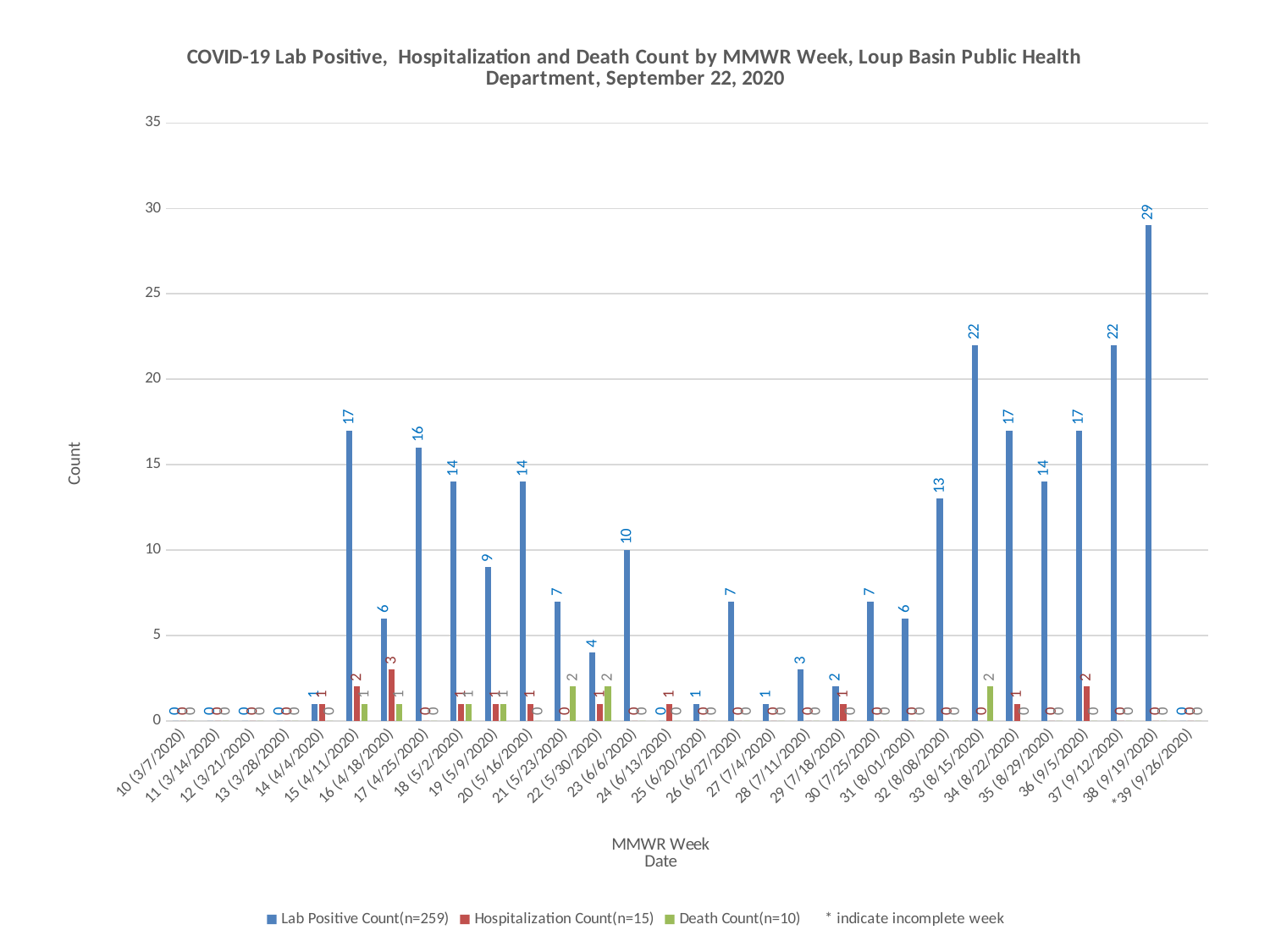
Is the Lab Positive Count for week 33 (8/15/2020) greater or less than 20? greater What does the asterisk (*) next to week 39 indicate, according to the legend? Incomplete week Which is larger, the Lab Positive Count for week 15 (4/11/2020) or week 17 (4/25/2020)? Week 15 (4/11/2020) Which MMWR week has the highest Lab Positive Count? 38 (9/19/2020) How many series does the legend list? 3 What is the Death Count for MMWR week 21 (5/23/2020)? 2 Which MMWR week has the highest Hospitalization Count? 16 (4/18/2020) How many MMWR weeks are shown on the x axis? 30 What is the difference between the Lab Positive Count for week 38 (9/19/2020) and week 37 (9/12/2020)? 7 What is the Hospitalization Count for MMWR week 16 (4/18/2020)? 3 What kind of chart is shown on the slide? Bar chart What is the Lab Positive Count for MMWR week 38 (9/19/2020)? 29